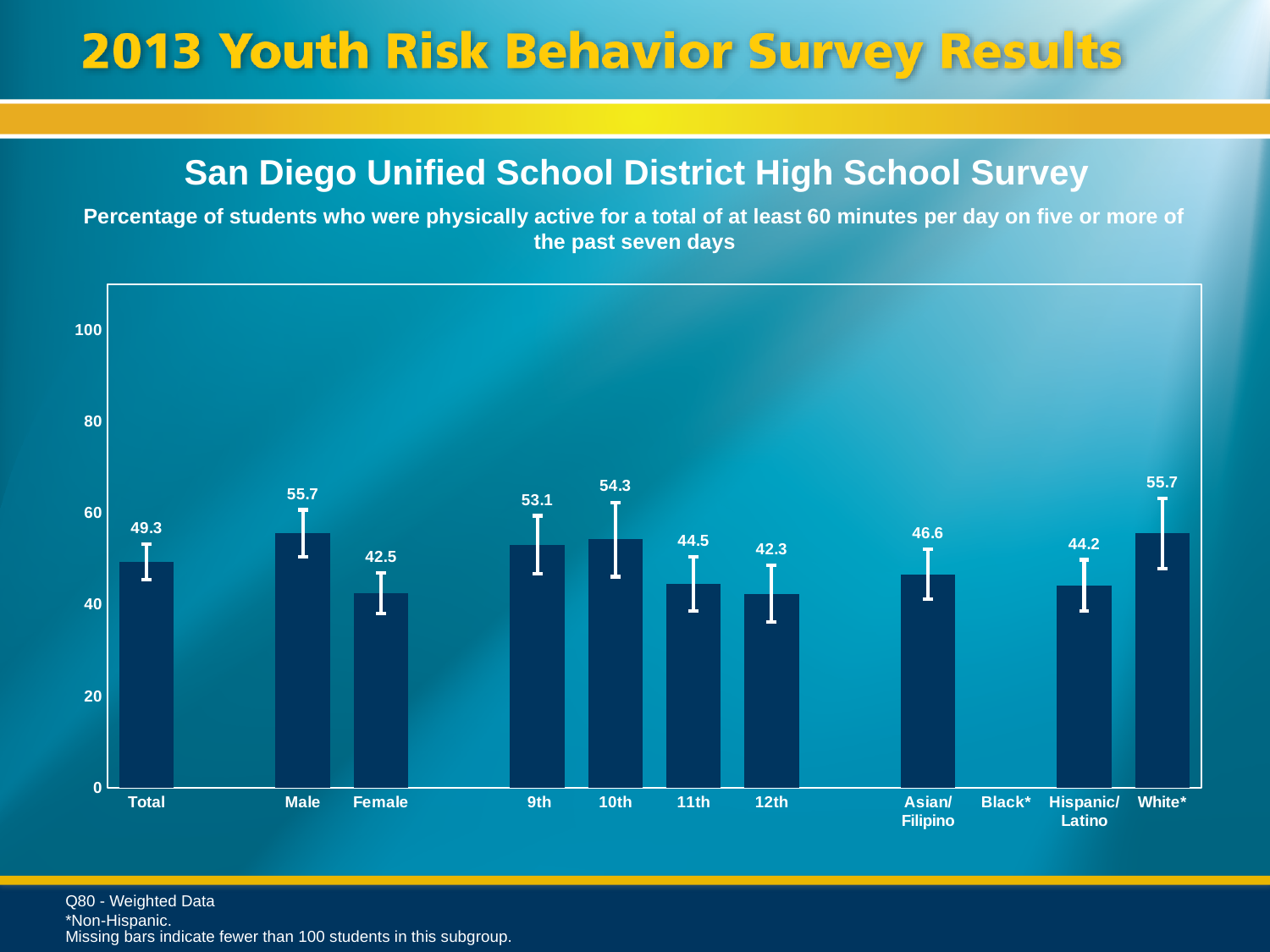
What is the value for Asian/Filipino? 46.6 What is the value for Total? 49.3 Which is larger, the value for 9th or the value for 11th? 9th How many bars are plotted on the chart? 10 What is the difference between the Male and Female values? 13.2 What is the value for Hispanic/Latino? 44.2 Among the grade levels (9th, 10th, 11th, 12th), which has the highest value? 10th Is the value for White* greater or less than 40? greater Among the grade levels (9th, 10th, 11th, 12th), which has the lowest value? 12th What is the value for Female? 42.5 Which category label on the x axis has no bar plotted? Black* What kind of chart is shown? Bar chart